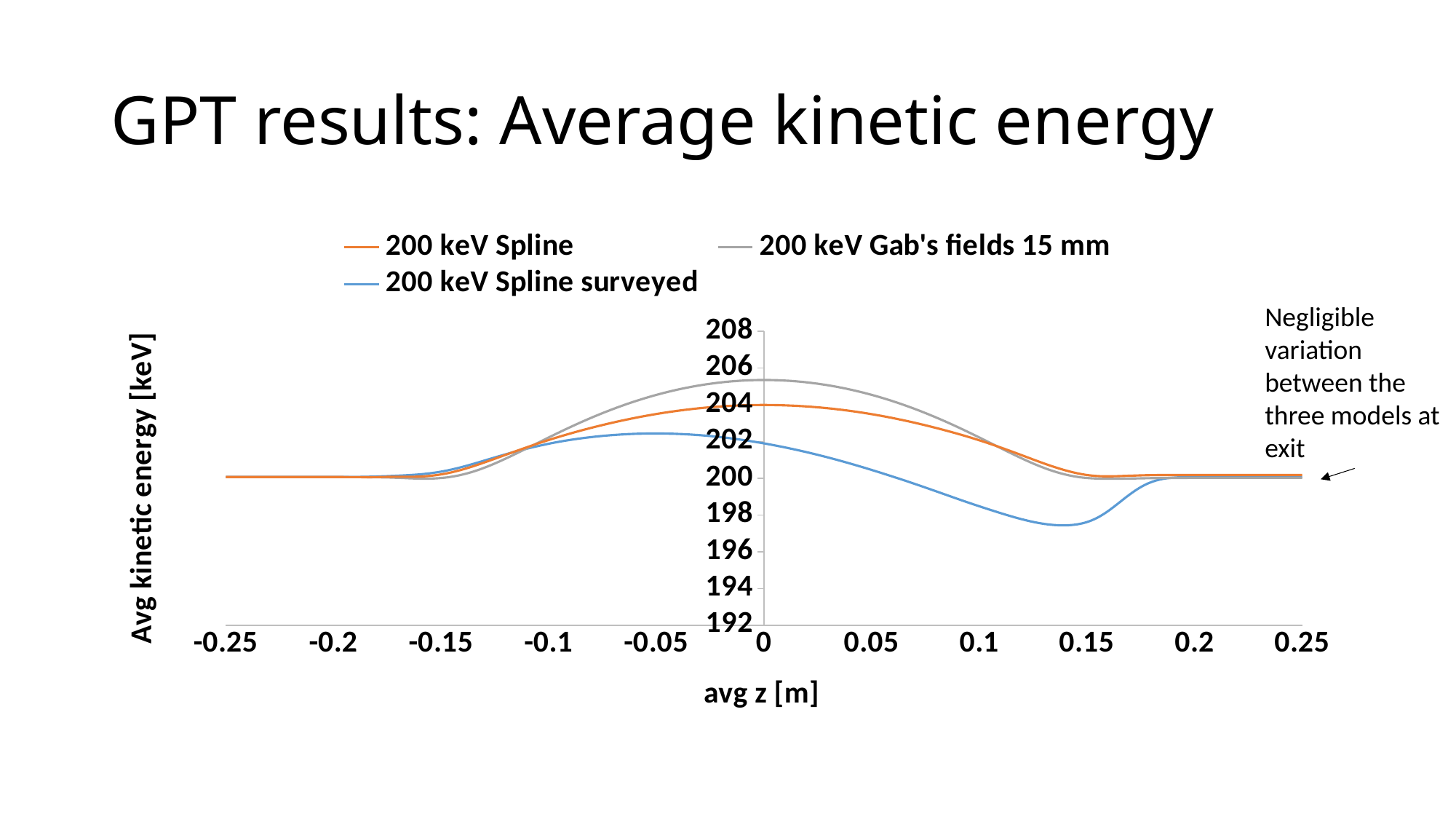
How many series does the legend list? 3 At avg z = 0.1 m, which series has the larger value: 200 keV Gab's fields 15 mm or 200 keV Spline surveyed? 200 keV Gab's fields 15 mm Is the value of the 200 keV Spline surveyed series at avg z = -0.05 m greater or less than 200? greater Is the peak value of the 200 keV Gab's fields 15 mm series greater or less than 204? greater What kind of chart is shown on the slide? line chart What is the label of the y axis? Avg kinetic energy [keV] What is the label of the x axis? avg z [m] Is the value of the 200 keV Spline surveyed series at avg z = 0.15 m greater or less than 200? less Which series dips to the lowest average kinetic energy? 200 keV Spline surveyed At avg z = 0 m, which series has the larger value: 200 keV Spline or 200 keV Spline surveyed? 200 keV Spline Which series reaches the highest average kinetic energy? 200 keV Gab's fields 15 mm